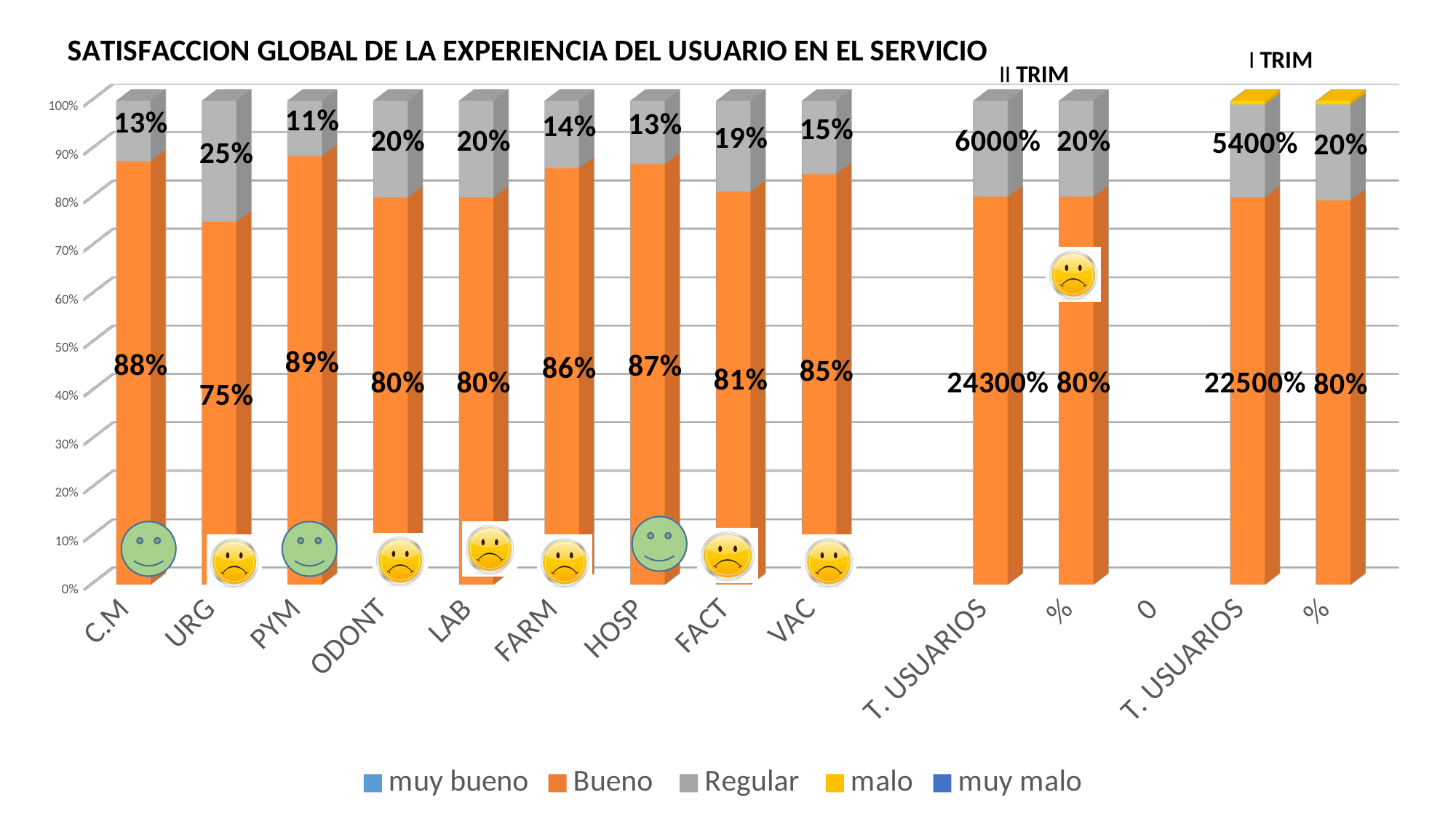
What is the difference between the Bueno values for HOSP and FARM? 1% How many series does the legend list? 5 Among the service categories C.M through VAC, which has the lowest Bueno value? URG What is the Bueno value for C.M? 88% What is the title of the chart? SATISFACCION GLOBAL DE LA EXPERIENCIA DEL USUARIO EN EL SERVICIO Which colour represents the Regular series in the chart? Grey What is the Regular value for URG? 25% What is the Bueno value for PYM? 89% What kind of chart is shown on the slide? Stacked bar chart Which has a larger Regular value, ODONT or VAC? ODONT Among the service categories C.M through VAC, which has the highest Bueno value? PYM What is the Regular value for FACT? 19%